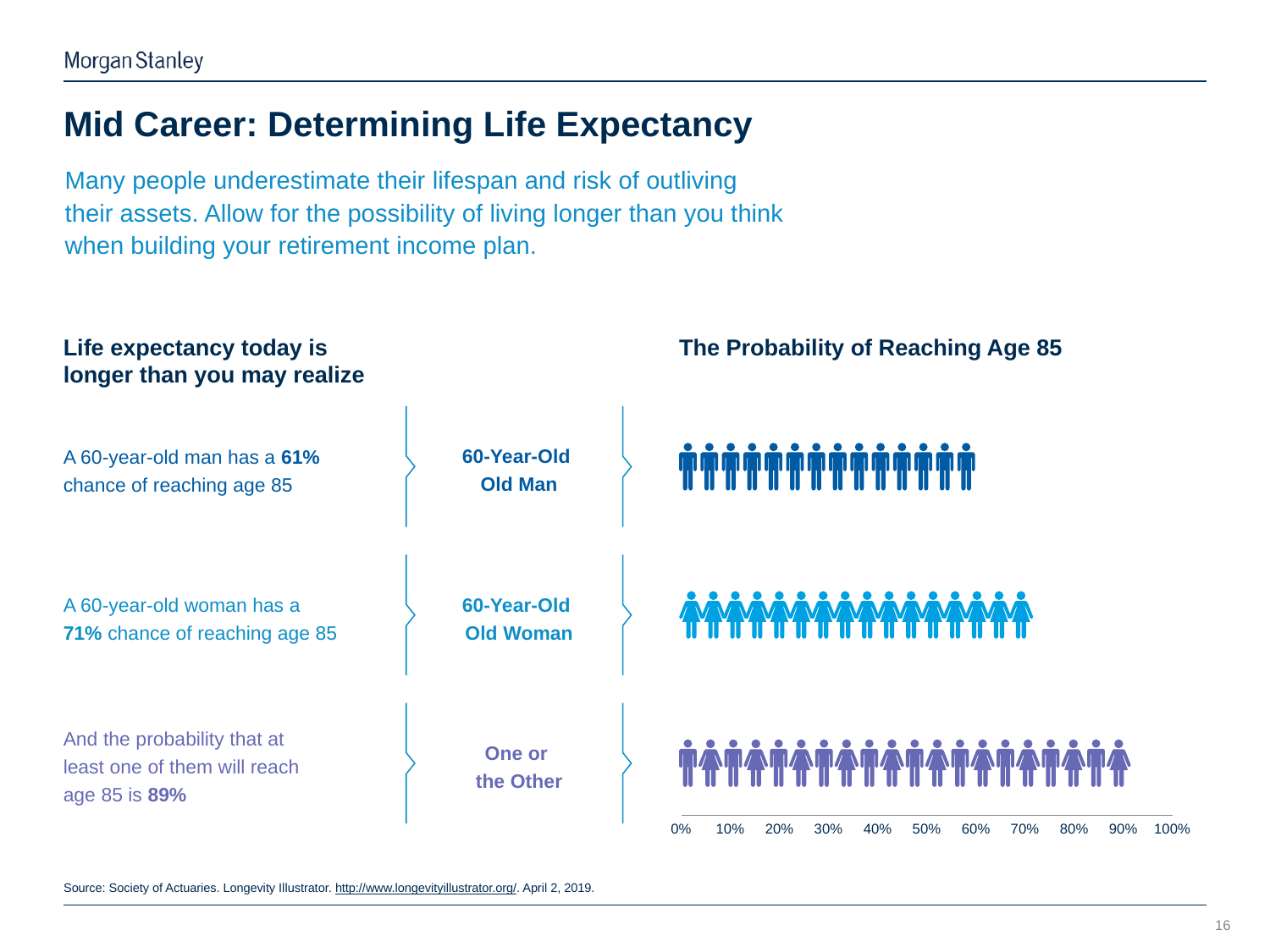
In the chart 'The Probability of Reaching Age 85', what is the difference between the probability for 'One or the Other' and the 60-Year-Old Old Woman? 18% In the chart 'The Probability of Reaching Age 85', which is larger: the probability for the 60-Year-Old Old Man or the 60-Year-Old Old Woman? 60-Year-Old Old Woman What is the title of the chart on the right side of the slide? The Probability of Reaching Age 85 What is the maximum value shown on the horizontal axis of the chart 'The Probability of Reaching Age 85'? 100% In the chart 'The Probability of Reaching Age 85', what is the value for the 60-Year-Old Old Woman? 71% In the chart 'The Probability of Reaching Age 85', is the value for 'One or the Other' greater or less than 80%? greater In the chart 'The Probability of Reaching Age 85', what is the difference between the probability for the 60-Year-Old Old Woman and the 60-Year-Old Old Man? 10% How many categories are shown in the chart 'The Probability of Reaching Age 85'? 3 In the chart 'The Probability of Reaching Age 85', what is the value for 'One or the Other'? 89% In the chart 'The Probability of Reaching Age 85', what is the value for the 60-Year-Old Old Man? 61% In the chart 'The Probability of Reaching Age 85', which category has the highest probability? One or the Other In the chart 'The Probability of Reaching Age 85', which category has the lowest probability? 60-Year-Old Old Man